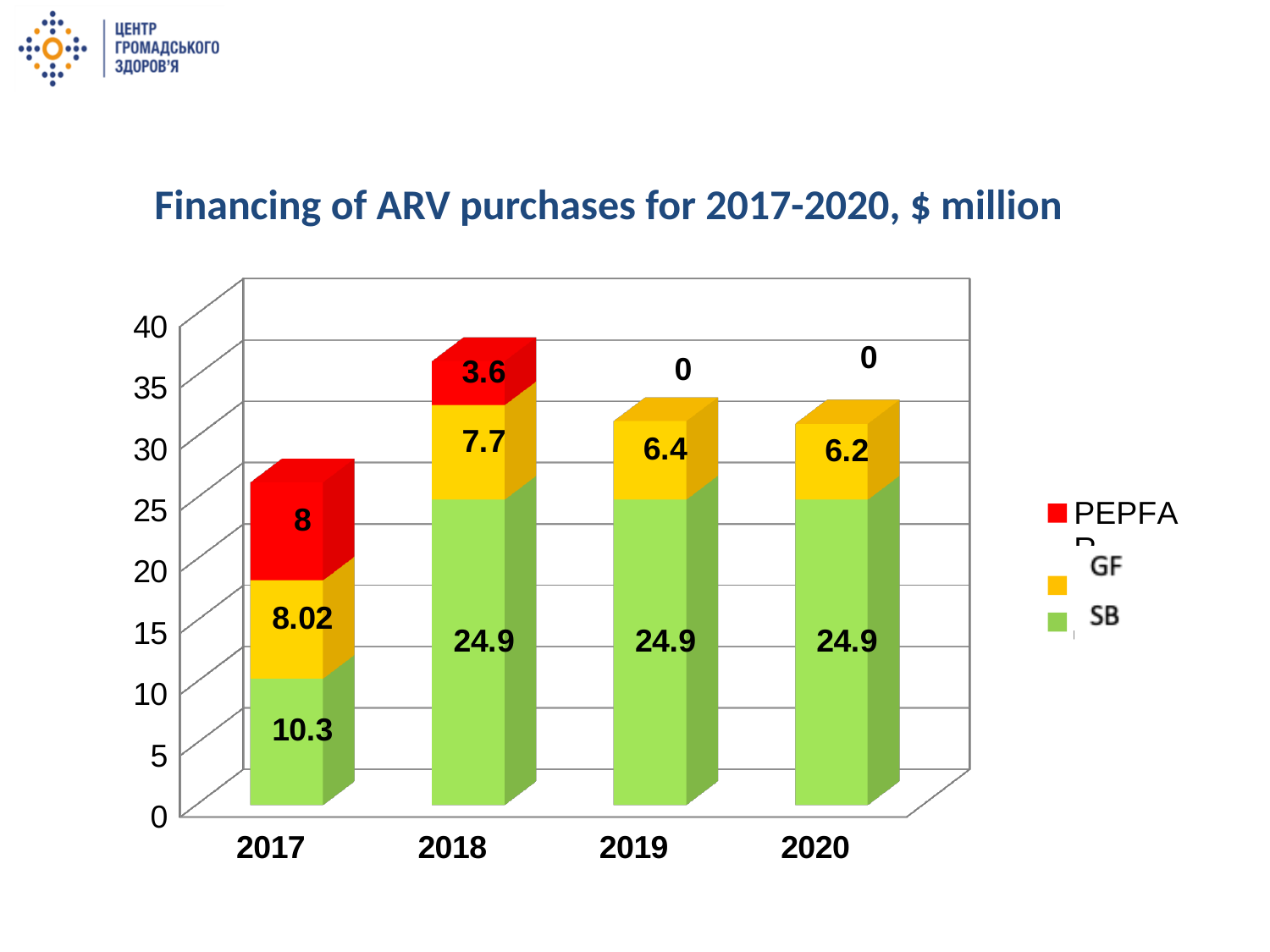
What is the SB value for 2017? 10.3 What is the difference between the SB values for 2018 and 2017? 14.6 What is the GF value for 2020? 6.2 What kind of chart is shown on the slide? Stacked bar chart How many years are shown on the x axis? 4 How many series does the legend list? 3 What is the total of the stacked bar for 2018? 36.2 What is the GF value for 2018? 7.7 Which is larger, the PEPFAR value for 2017 or for 2018? 2017 What is the PEPFAR value for 2019? 0 In which year is the GF value the highest? 2017 In which year is the SB value the lowest? 2017